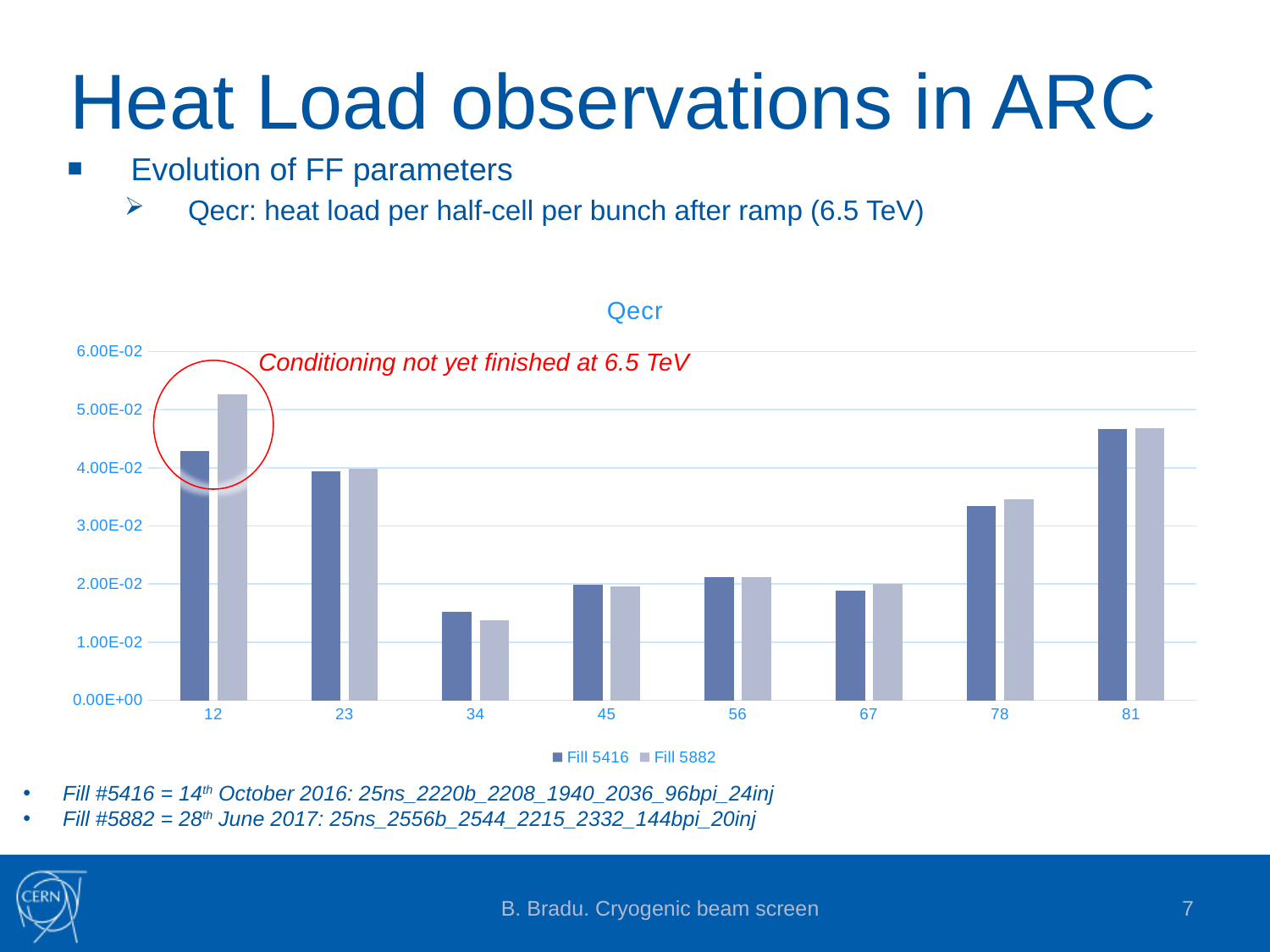
Which category has the lowest value for Fill 5882? 34 How many series does the legend list? 2 What kind of chart is shown on the slide? bar chart What are the two series names listed in the legend? Fill 5416 and Fill 5882 At category 12, which series has the larger value, Fill 5416 or Fill 5882? Fill 5882 Which category has the highest value for Fill 5882? 12 Which category has the lowest value for Fill 5416? 34 Is the value for Fill 5416 at category 81 greater or less than 4.00E-02? greater Is the value for Fill 5416 at category 34 greater or less than 2.00E-02? less How many categories are shown on the x axis? 8 Is the value for Fill 5882 at category 12 greater or less than 5.00E-02? greater What is the title of the chart? Qecr